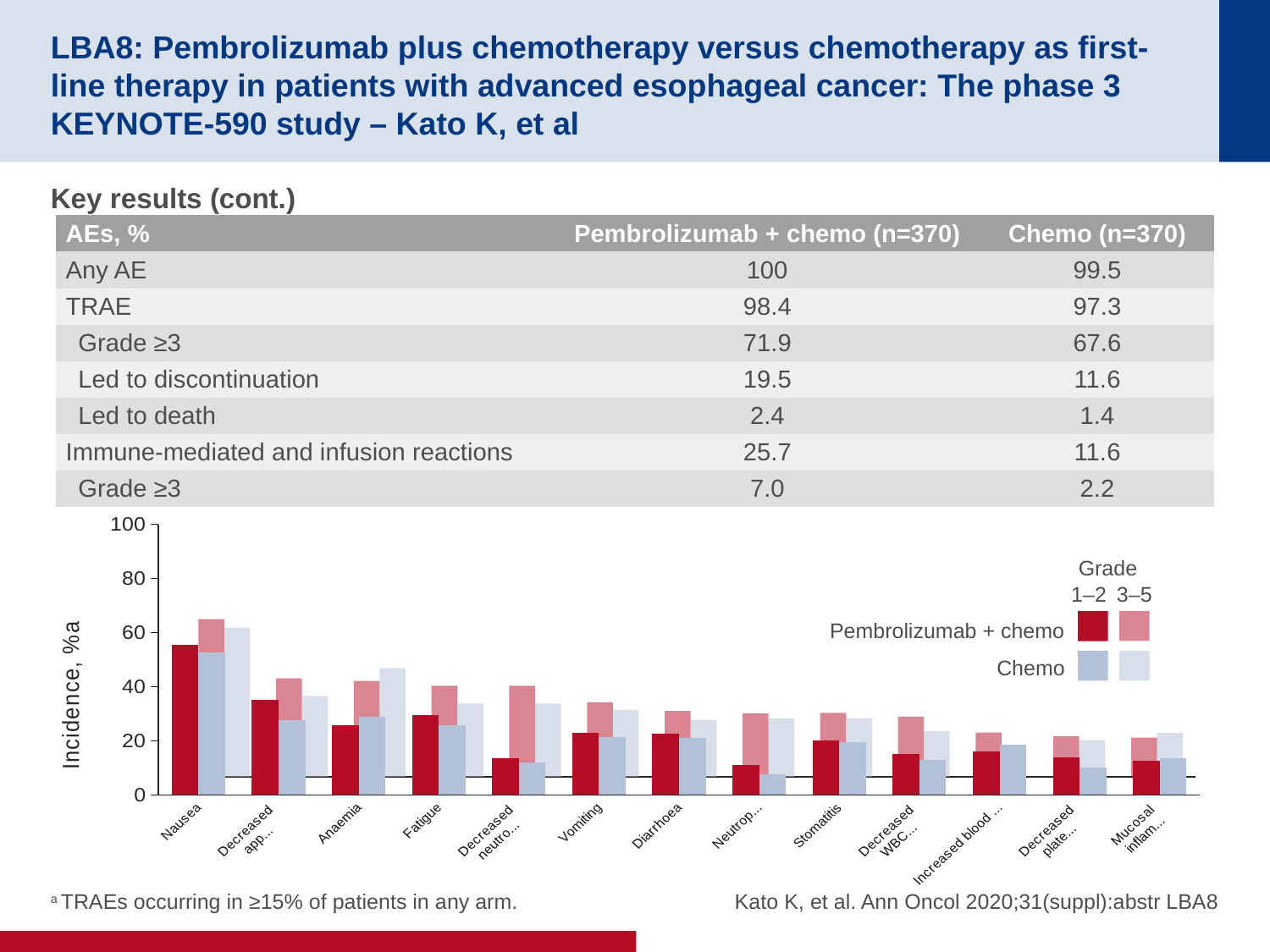
Is the total incidence of anaemia for Chemo greater or less than 40? greater For anaemia, which arm has the higher total incidence, Pembrolizumab + chemo or Chemo? Chemo Is the total incidence of vomiting for Pembrolizumab + chemo greater or less than 40? less Is the total incidence of nausea for Pembrolizumab + chemo greater or less than 60? greater How many series does the chart legend list? 4 What kind of chart is shown at the bottom of the slide? Stacked bar chart How many adverse event categories are plotted along the x axis of the chart? 13 What is the label of the y axis of the chart? Incidence, % Which adverse event category has the highest incidence in the chart? Nausea Do the incidence values generally rise or fall moving from left to right along the x axis? Fall For decreased appetite, which arm has the higher total incidence, Pembrolizumab + chemo or Chemo? Pembrolizumab + chemo